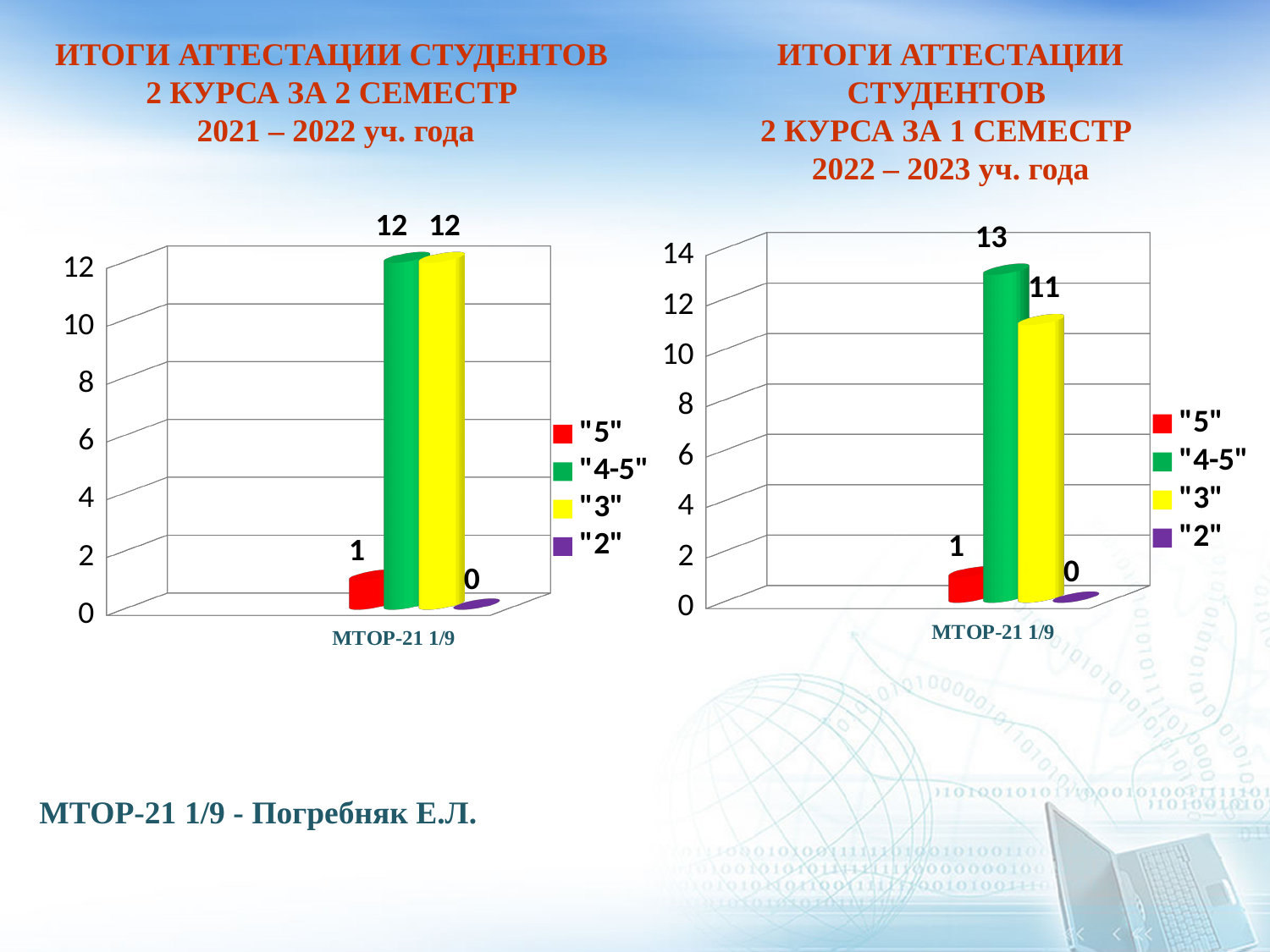
What kind of chart is the right chart (1 семестр 2022–2023)? Bar chart In the right chart (1 семестр 2022–2023), what is the value for the "3" series? 11 In the right chart (1 семестр 2022–2023), what is the difference between the "4-5" value and the "3" value? 2 In the right chart (1 семестр 2022–2023), which is larger: the "4-5" value or the "3" value? "4-5" In the right chart, what colour is the bar for the "3" series? Yellow In the left chart (2 семестр 2021–2022), which series has the lowest value? "2" How many series does the legend of the left chart list? 4 What is the category label on the x axis of the left chart? МТОР-21 1/9 In the left chart (2 семестр 2021–2022), what is the value for the "4-5" series? 12 In the right chart (1 семестр 2022–2023), what is the value for the "2" series? 0 In the right chart (1 семестр 2022–2023), which series has the highest value? "4-5" In the left chart (2 семестр 2021–2022), what is the value for the "5" series? 1